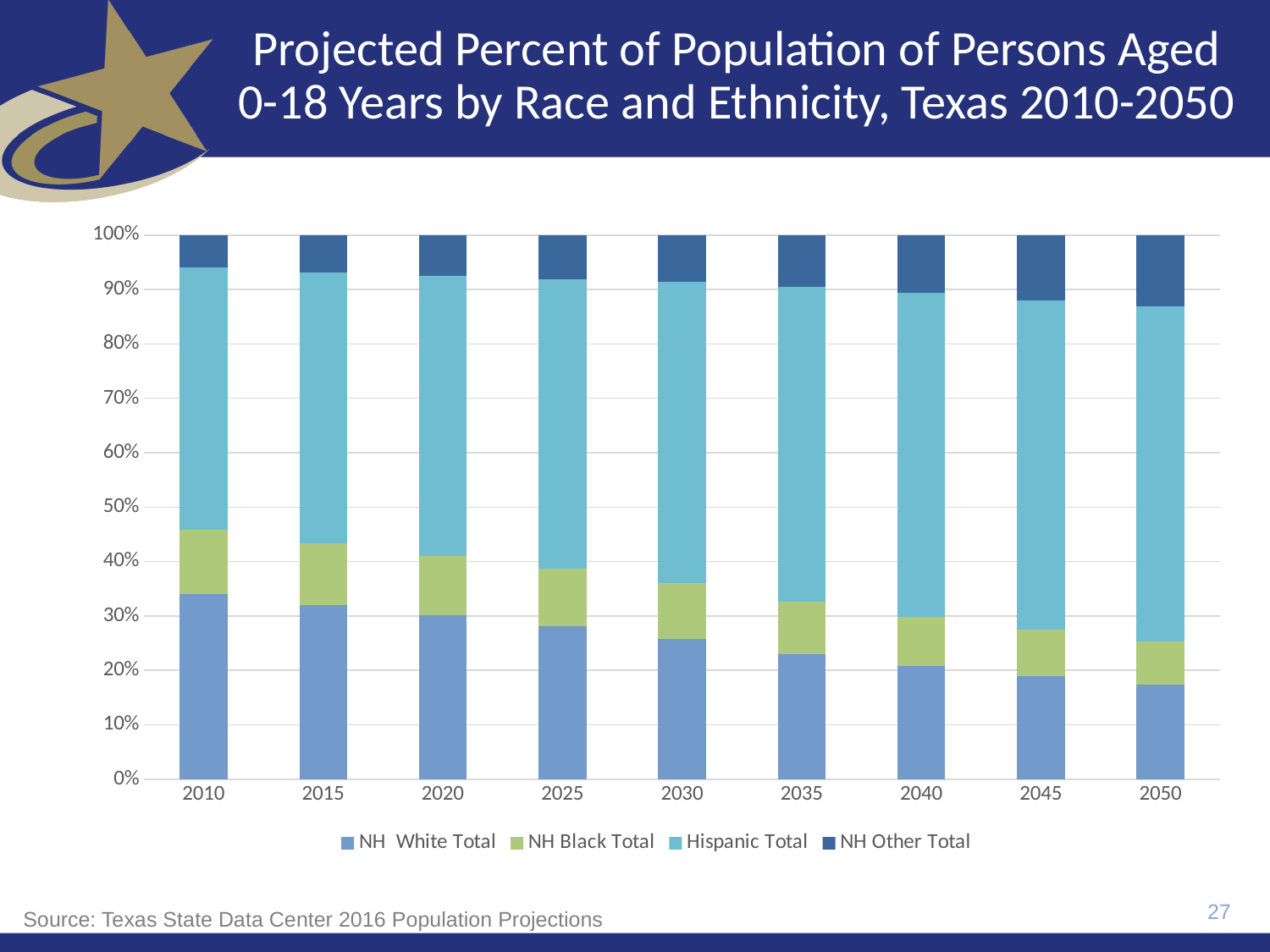
How many series does the chart's legend list? 4 What kind of chart is shown on the slide? Stacked bar chart Is the NH White Total share in 2050 greater or less than 20%? less How many years are shown along the x axis of the chart? 9 Does the Hispanic Total share rise or fall from 2010 to 2050? rise In which year is the NH White Total share lowest? 2050 Which series is shown in the darkest blue at the top of each bar? NH Other Total In which year is the NH White Total share highest? 2010 Which is larger, the NH Other Total share in 2010 or in 2050? 2050 Is the NH White Total share in 2010 greater or less than 30%? greater Does the NH White Total share rise or fall from 2010 to 2050? fall Is the Hispanic Total share in 2050 greater or less than 50%? greater